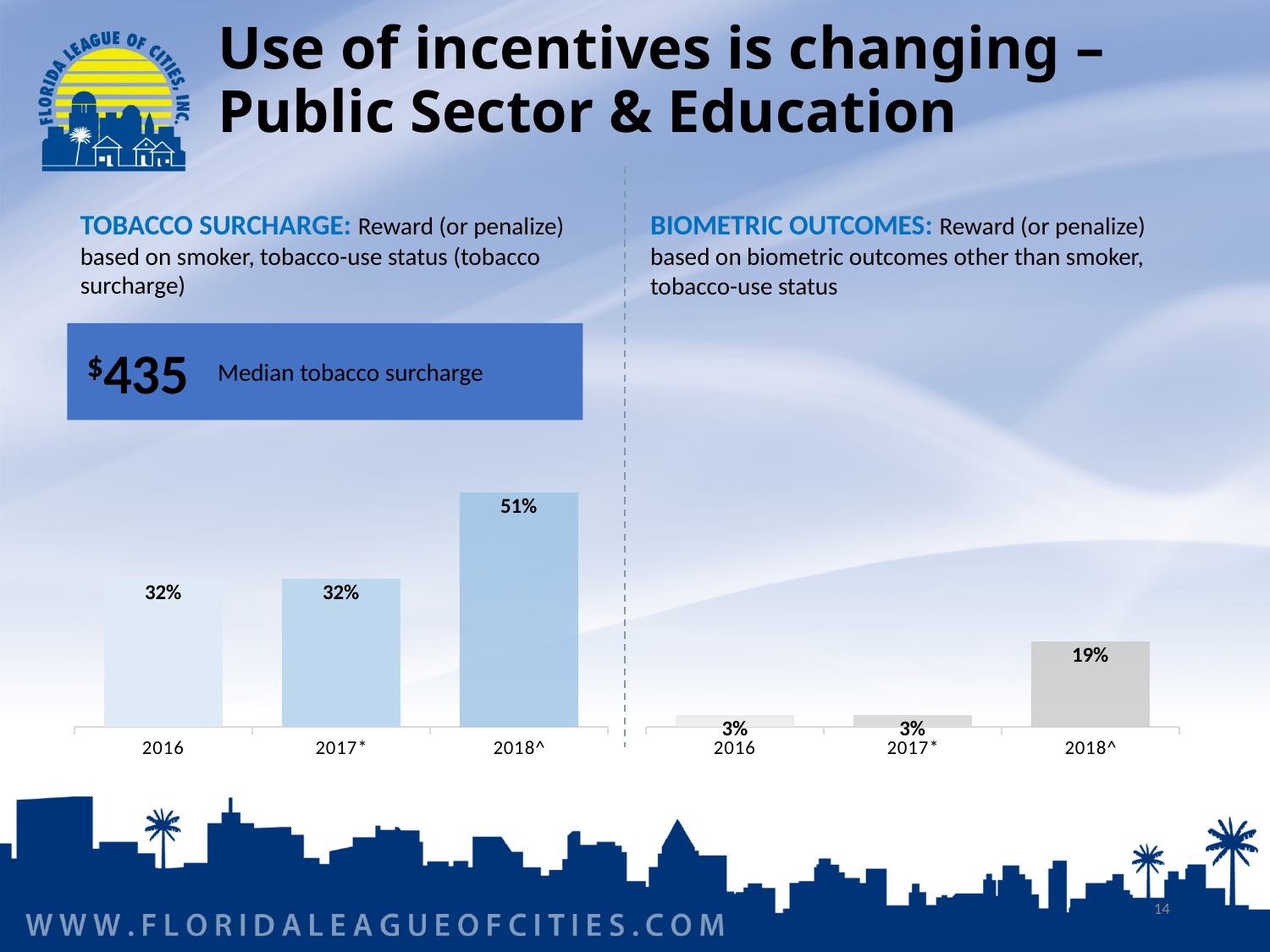
How many years are shown on the x axis of the Tobacco Surcharge chart on the left? 3 In the Biometric Outcomes chart on the right, what is the value for 2017*? 3% In the Biometric Outcomes chart on the right, what is the value for 2018^? 19% In the Tobacco Surcharge chart on the left, what is the difference between the 2018^ value and the 2017* value? 19% In the Tobacco Surcharge chart on the left, which year has the highest value? 2018^ In the Tobacco Surcharge chart on the left, what is the value for 2016? 32% What kind of chart is the Biometric Outcomes chart on the right? Bar chart Which is larger: the 2018^ value in the Tobacco Surcharge chart or the 2018^ value in the Biometric Outcomes chart? Tobacco Surcharge (51%) In the Biometric Outcomes chart on the right, what is the difference between the 2018^ value and the 2016 value? 16% In the Biometric Outcomes chart on the right, do the values rise or fall from 2016 to 2018^? Rise In the Biometric Outcomes chart on the right, which year has the highest value? 2018^ In the Tobacco Surcharge chart on the left, what is the value for 2018^? 51%